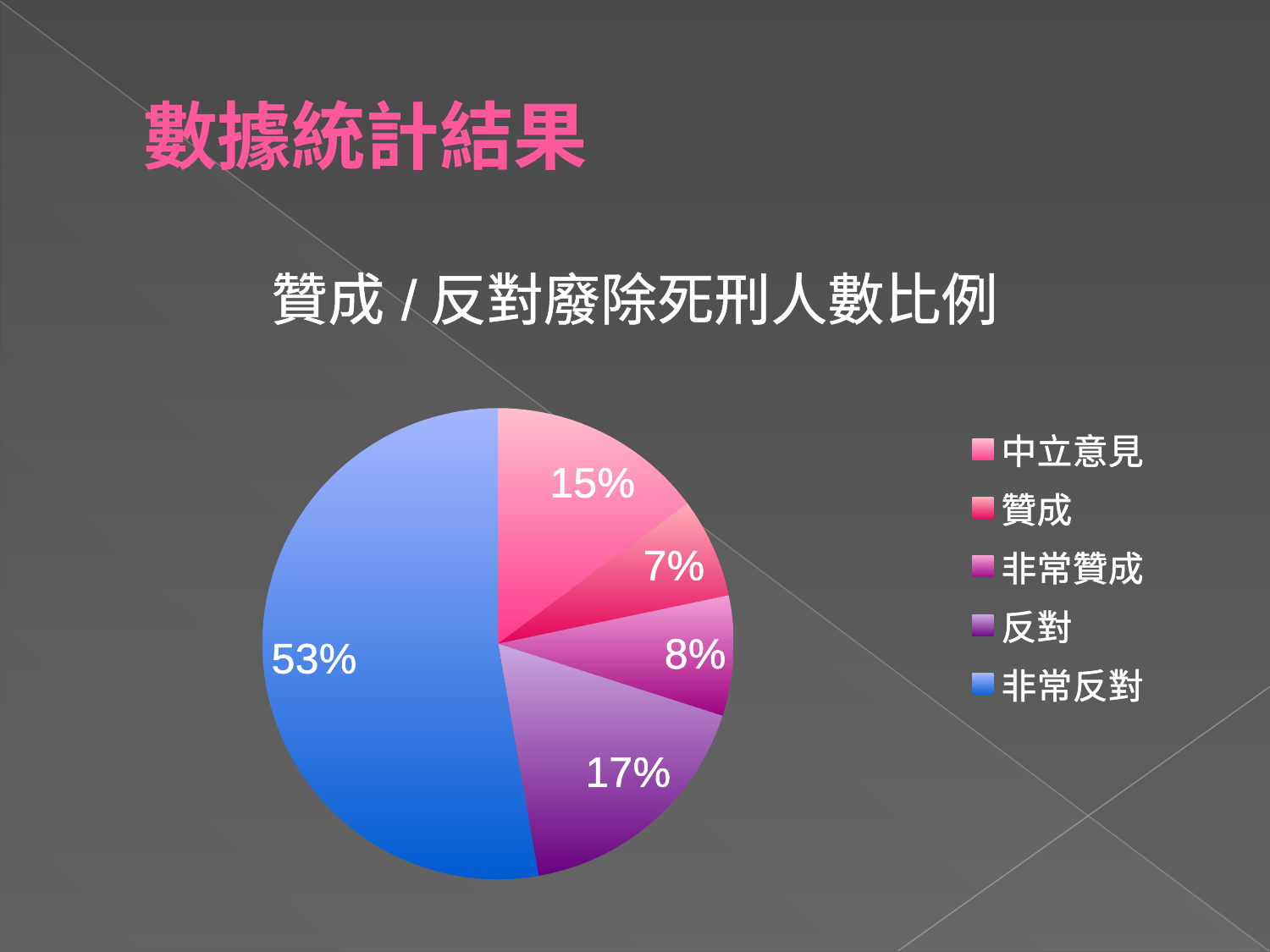
What share of the pie is 反對? 17% What type of chart is shown on the slide? pie chart How many categories does the legend list? 5 What share of the pie is 非常贊成? 8% What share of the pie is 中立意見? 15% Which category has the largest slice? 非常反對 What is the difference between the shares of 非常反對 and 反對? 36% Which category has the smallest slice? 贊成 How many slices does the pie chart have? 5 What is the title of the chart? 贊成 / 反對廢除死刑人數比例